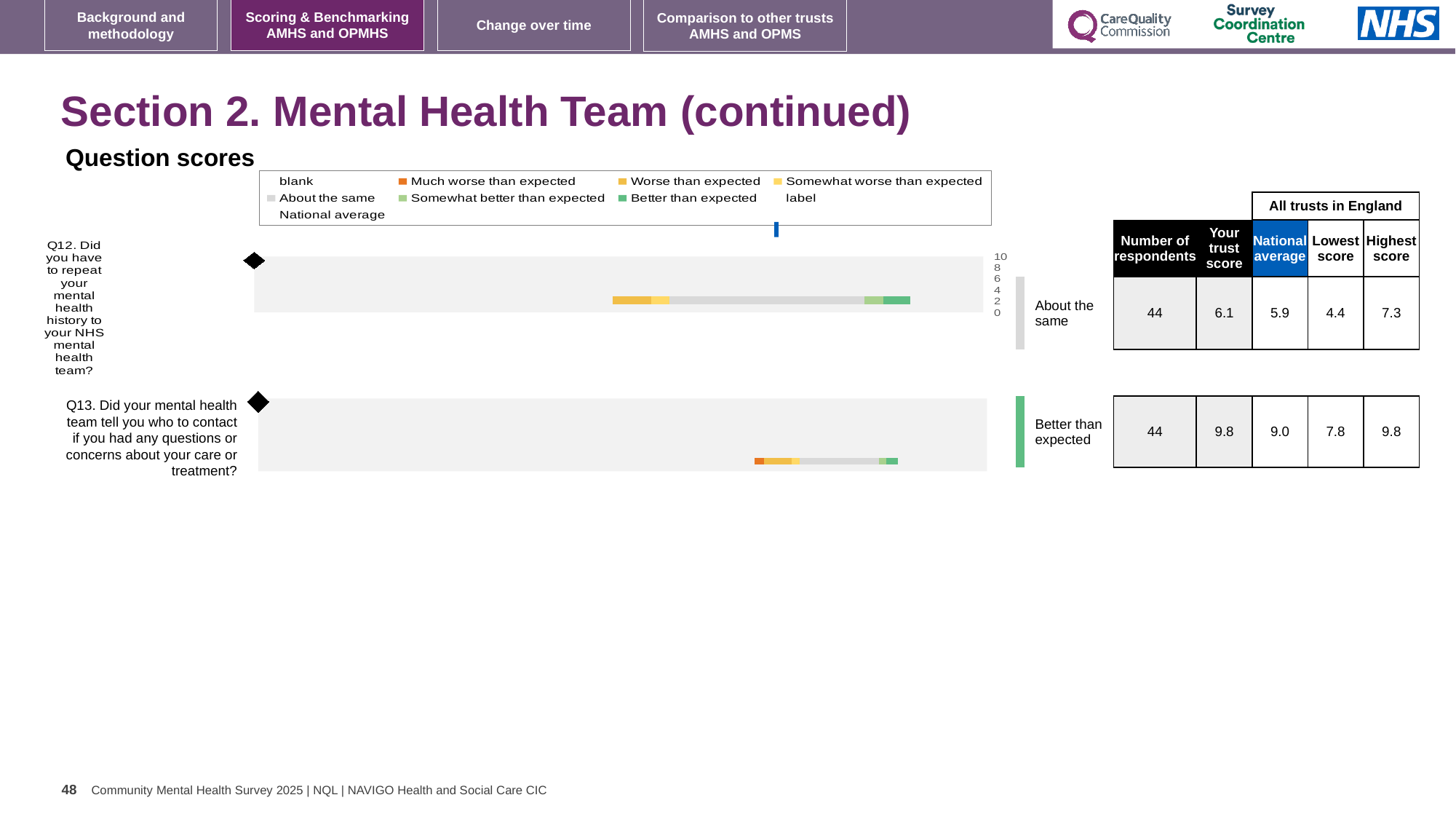
What benchmark category label is shown beside the Q13 chart? Better than expected What is the highest score among all trusts in England for Q12? 7.3 According to the table next to the Q13 chart, what is the trust's score for Q13? 9.8 What is the national average shown for Q13? 9.0 How many respondents are shown for Q13? 44 What benchmark category label is shown beside the Q12 chart? About the same What kind of chart is used to show the question scores for Q12 and Q13? bar chart Which question has the higher trust score, Q12 or Q13? Q13 What is the national average shown for Q12? 5.9 What is the difference between the trust score for Q13 and the trust score for Q12? 3.7 According to the table next to the Q12 chart, what is the trust's score for Q12? 6.1 What is the lowest score among all trusts in England for Q13? 7.8